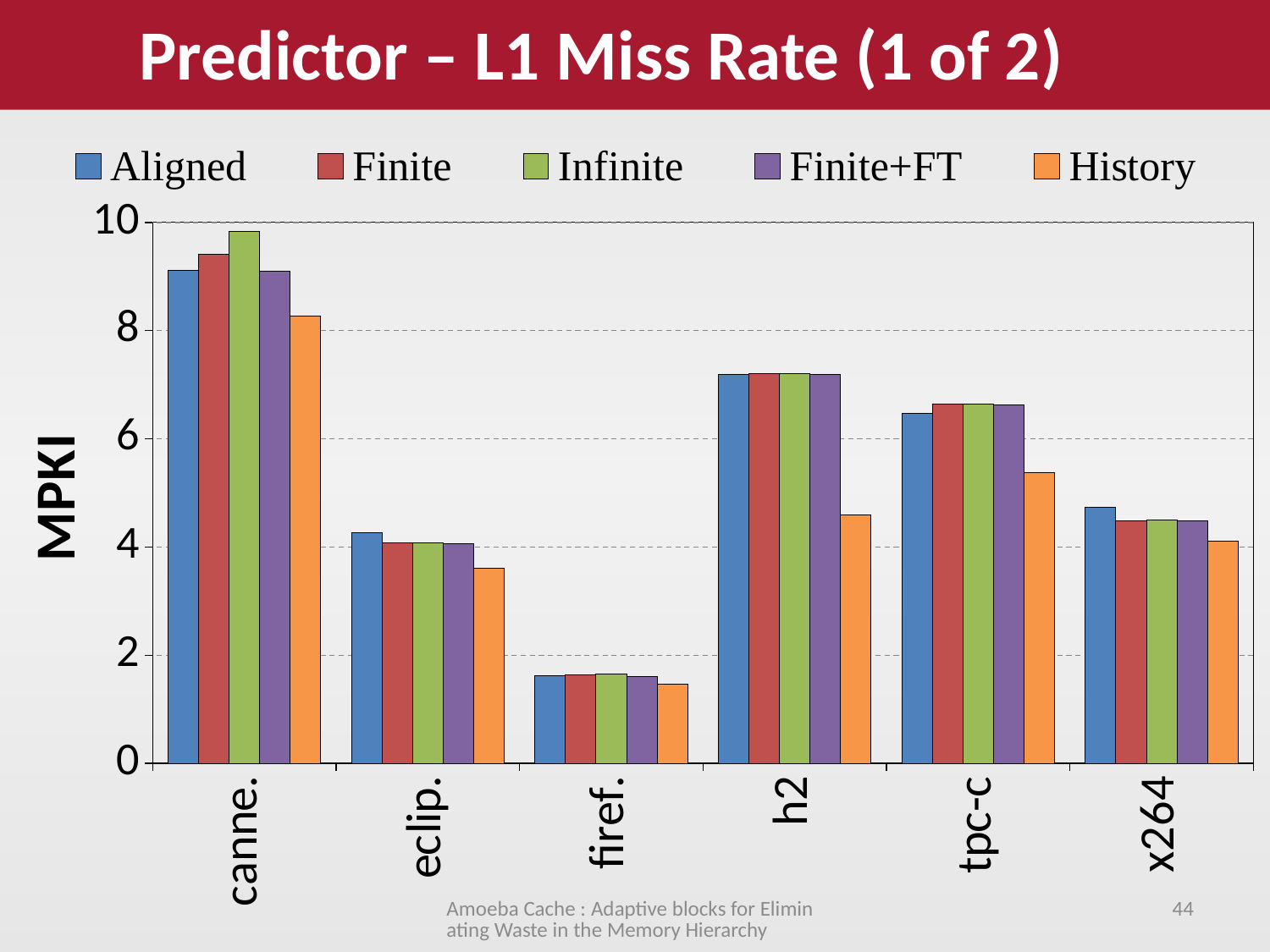
Which category has the highest Infinite value? canne. What is the label on the y axis? MPKI Which category has the lowest Aligned value? firef. What kind of chart is shown on the slide? bar chart Is the Aligned value for firef. greater or less than 2? less How many categories are shown on the x axis? 6 Is the Infinite value for canne. greater or less than 8? greater How many series does the legend list? 5 For canne., which series has the highest value? Infinite For h2, which series has the lowest value? History For h2, which is larger: the Aligned value or the History value? Aligned What is the title of the chart? Predictor – L1 Miss Rate (1 of 2)